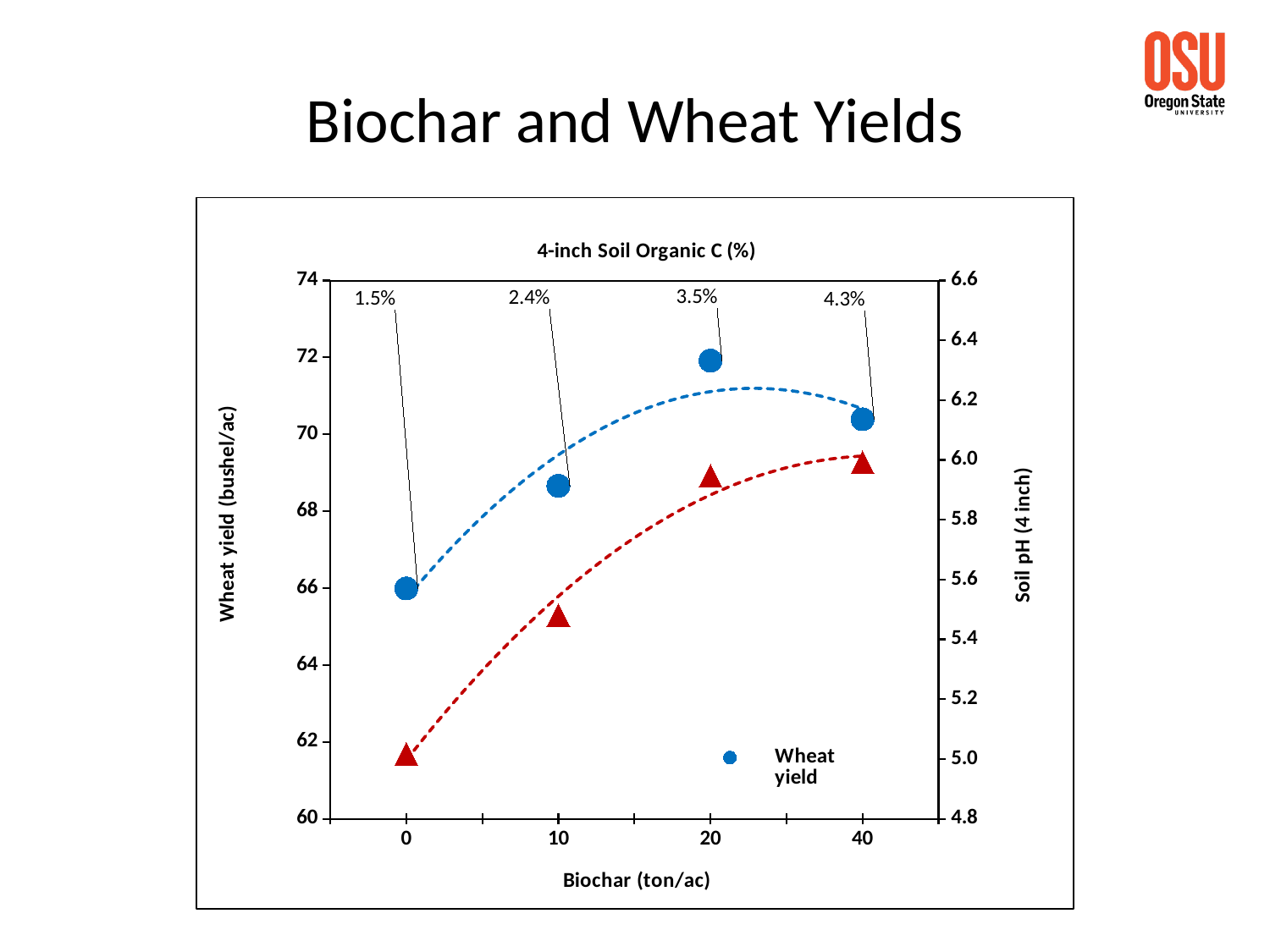
Which has the larger wheat yield, 20 ton/ac or 40 ton/ac of biochar? 20 ton/ac Is the wheat yield at 20 ton/ac of biochar greater or less than 70 bushel/ac? greater What is the difference between the soil organic C labels at 40 ton/ac and 0 ton/ac of biochar? 2.8% What is the 4-inch soil organic C value labelled at 40 ton/ac of biochar? 4.3% Does soil pH rise or fall as the biochar rate increases from 0 to 40 ton/ac? rises What is the 4-inch soil organic C value labelled at 20 ton/ac of biochar? 3.5% At which biochar rate is the wheat yield lowest? 0 ton/ac Is the wheat yield at 10 ton/ac of biochar greater or less than 70 bushel/ac? less What kind of chart is shown on the slide? scatter chart How many biochar application rates are plotted on the x axis? 4 What is the 4-inch soil organic C value labelled at 0 ton/ac of biochar? 1.5% At which biochar rate is the wheat yield highest? 20 ton/ac